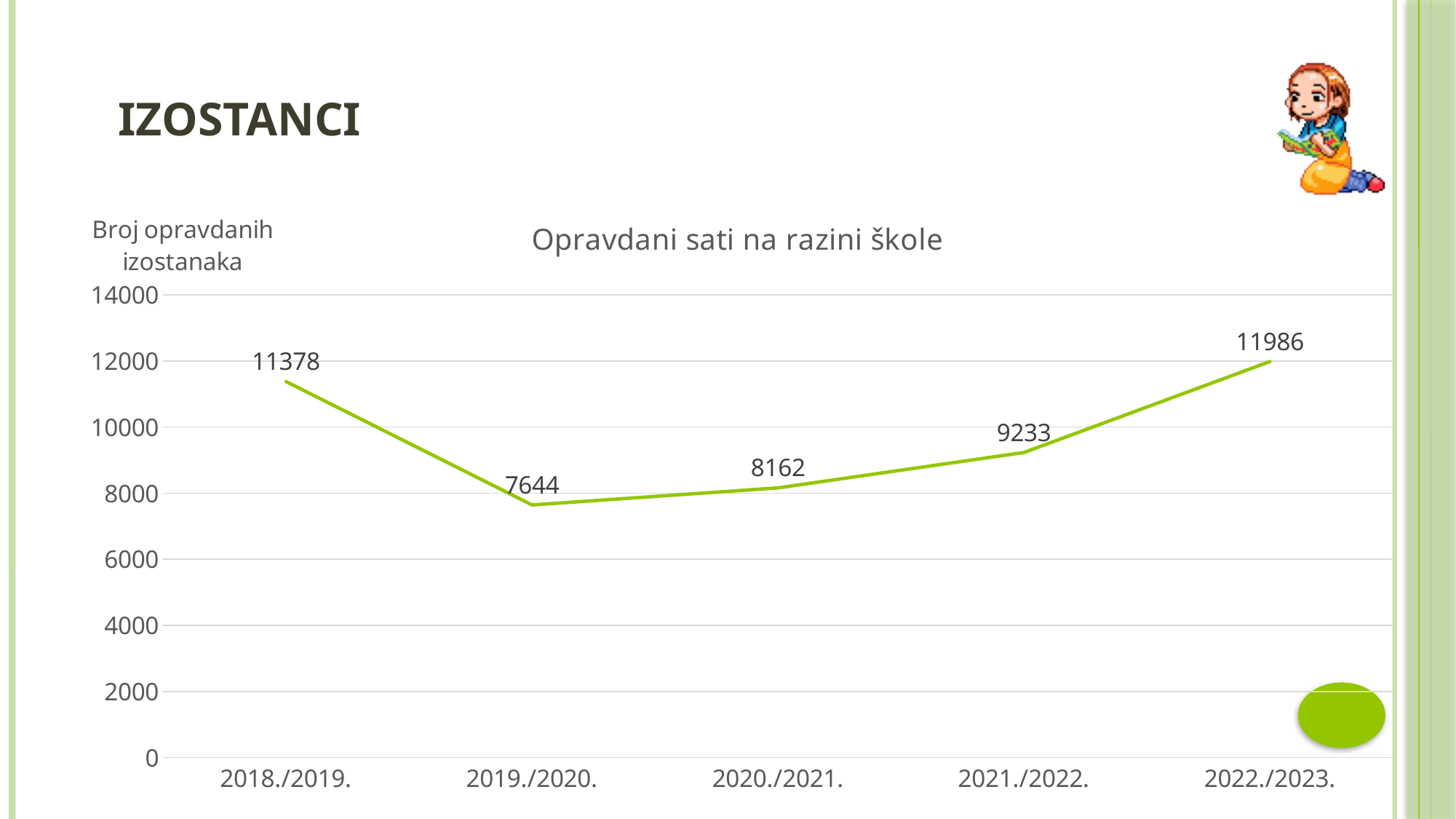
What is the value for 2020./2021.? 8162 What is the value for 2018./2019.? 11378 What is the title of the chart? Opravdani sati na razini škole What is the value for 2019./2020.? 7644 What is the value for 2021./2022.? 9233 Which school year has the lowest value? 2019./2020. Which school year has the highest value? 2022./2023. What is the value for 2022./2023.? 11986 What is the difference between the values for 2022./2023. and 2018./2019.? 608 How many school years are plotted on the chart? 5 Which is larger, the value for 2020./2021. or the value for 2021./2022.? 2021./2022. What kind of chart is shown on the slide? line chart